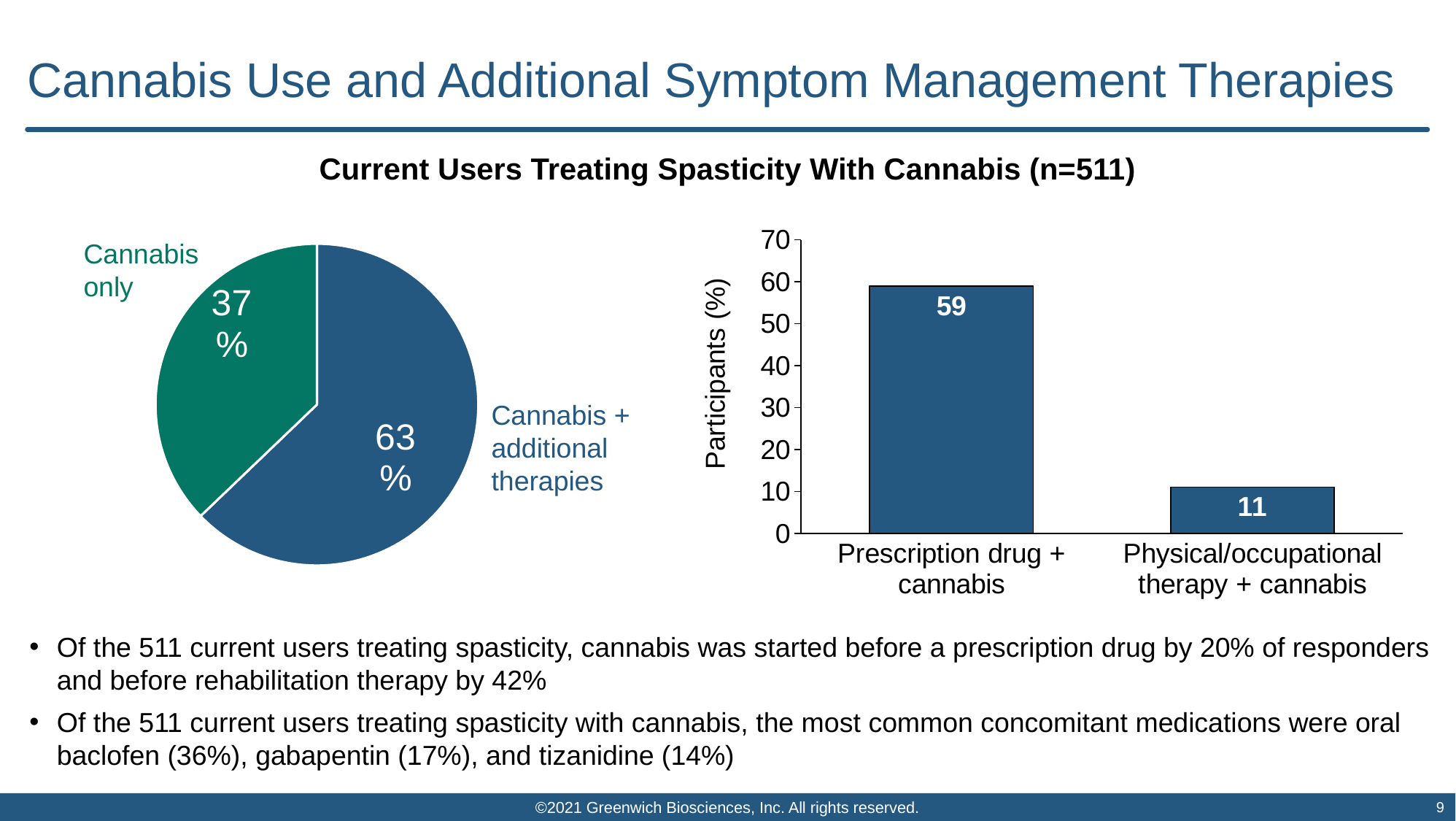
In the bar chart on the right, what is the label of the y axis? Participants (%) In the pie chart on the left, which slice is larger: 'Cannabis only' or 'Cannabis + additional therapies'? Cannabis + additional therapies What kind of chart is the chart on the right of the slide? Bar chart In the bar chart on the right, how many categories are shown on the x axis? 2 In the bar chart on the right, what is the value for 'Physical/occupational therapy + cannabis'? 11 What kind of chart is the chart on the left of the slide? Pie chart In the pie chart on the left, what share of current users is 'Cannabis + additional therapies'? 63% In the pie chart on the left, how many slices are there? 2 In the pie chart on the left, what share of current users is 'Cannabis only'? 37% In the bar chart on the right, which category has the highest value? Prescription drug + cannabis In the bar chart on the right, what is the value for 'Prescription drug + cannabis'? 59 In the bar chart on the right, what is the difference between the values for 'Prescription drug + cannabis' and 'Physical/occupational therapy + cannabis'? 48